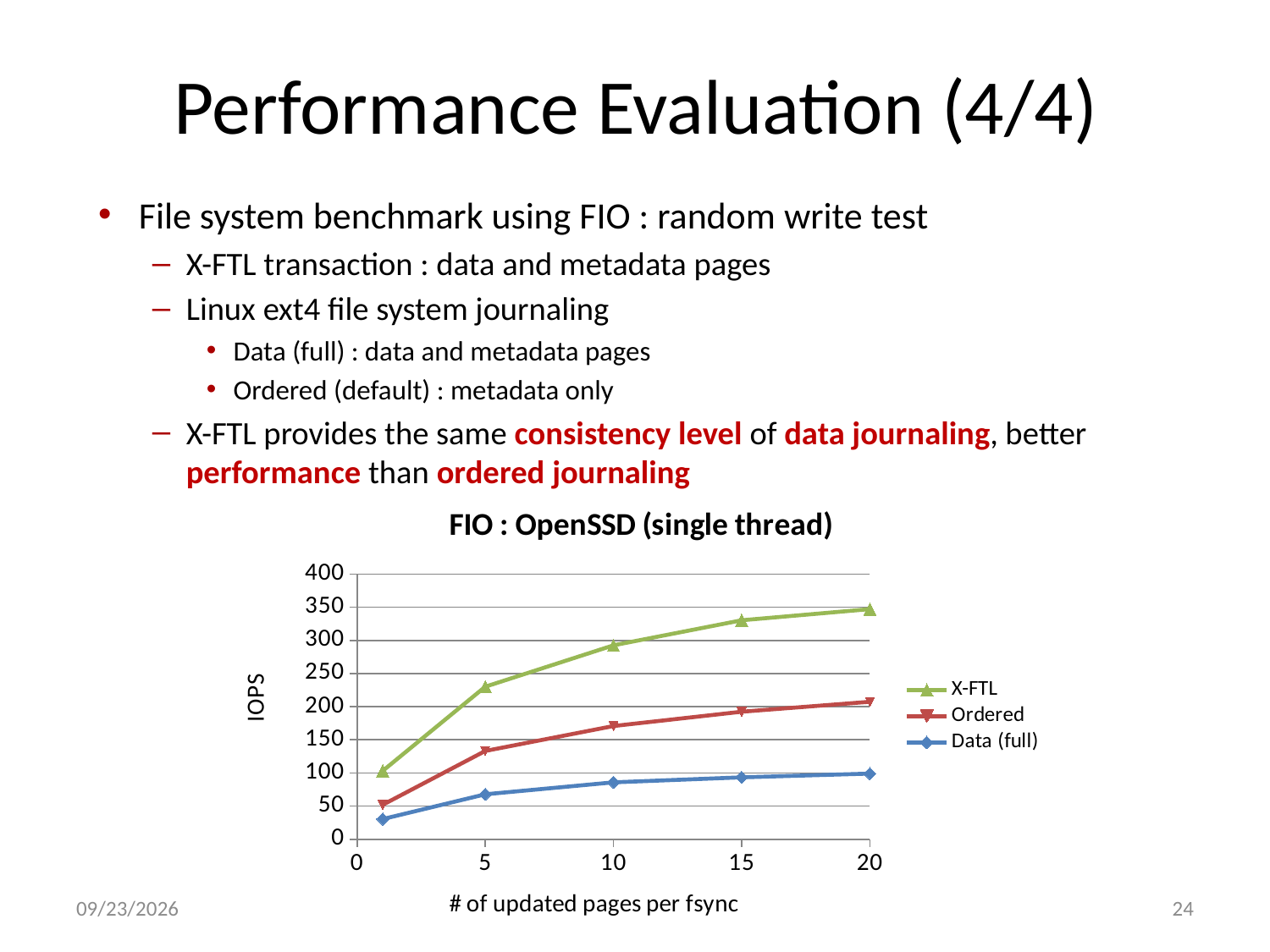
At 10 updated pages per fsync, which is larger: the value for Ordered or the value for Data (full)? Ordered Do the IOPS for X-FTL rise or fall as the number of updated pages per fsync increases? rise Which series has the highest IOPS at 20 updated pages per fsync? X-FTL What is the title of the chart? FIO : OpenSSD (single thread) Which series has the lowest IOPS at 20 updated pages per fsync? Data (full) Is the value for Data (full) at 1 updated page per fsync greater or less than 50? less Is the value for X-FTL at 20 updated pages per fsync greater or less than 300? greater What is the label of the y axis? IOPS What kind of chart is shown on the slide? line chart Is the value for Ordered at 20 updated pages per fsync greater or less than 150? greater How many series does the legend list? 3 How many data points are plotted for the X-FTL series? 5